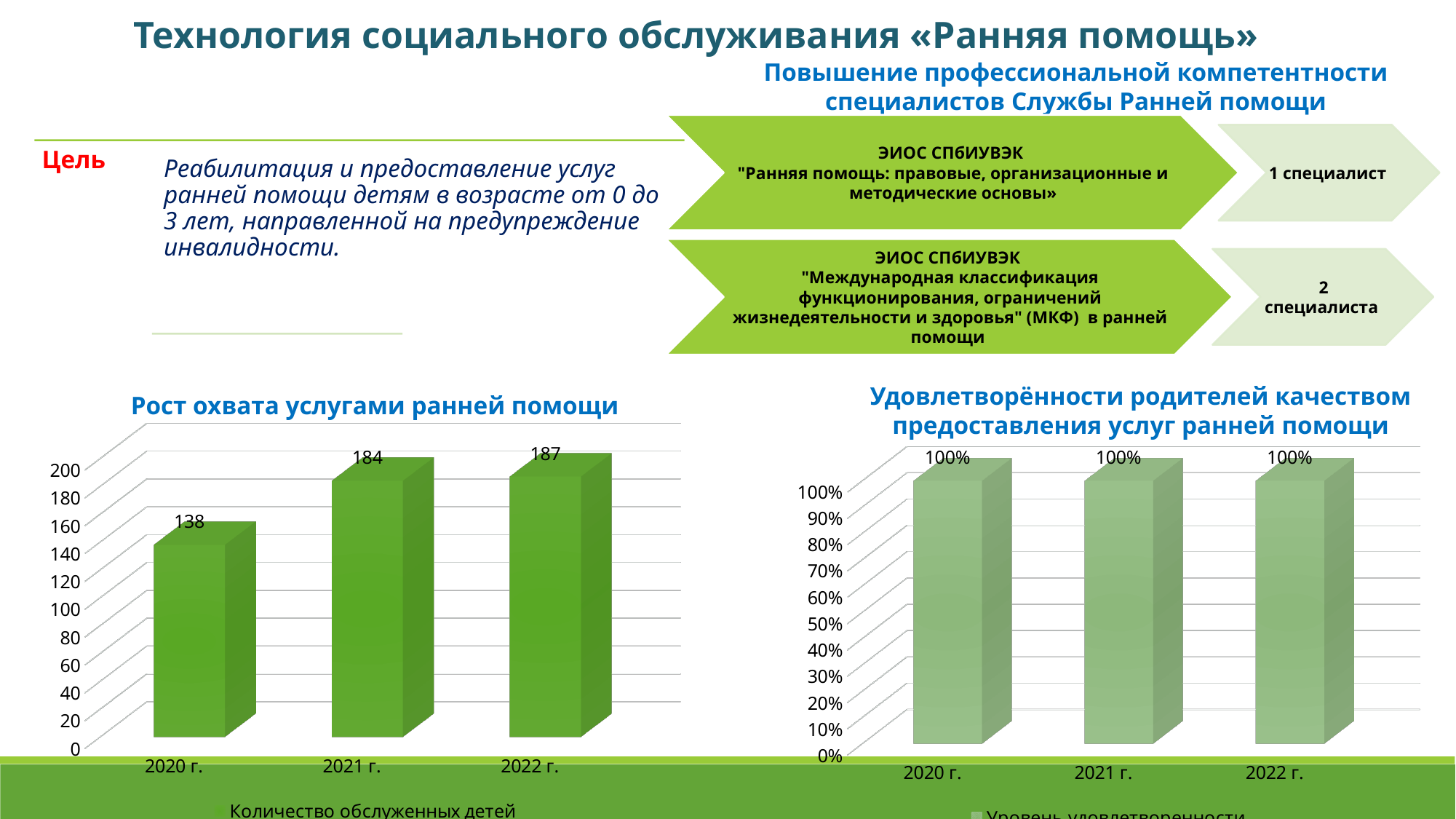
What kind of chart is 'Удовлетворённости родителей качеством предоставления услуг ранней помощи'? bar chart In the chart 'Рост охвата услугами ранней помощи', which year has the lowest value? 2020 г. In the chart 'Рост охвата услугами ранней помощи', what is the difference between the values for 2021 г. and 2020 г.? 46 In the chart 'Рост охвата услугами ранней помощи', what is the legend entry for the series? Количество обслуженных детей In the chart 'Удовлетворённости родителей качеством предоставления услуг ранней помощи', what is the value for 2021 г.? 100% In the chart 'Рост охвата услугами ранней помощи', do the values rise or fall from 2020 г. to 2022 г.? rise In the chart 'Рост охвата услугами ранней помощи', what is the value for 2022 г.? 187 In the chart 'Рост охвата услугами ранней помощи', how many years are shown on the x axis? 3 In the chart 'Рост охвата услугами ранней помощи', what is the value for 2021 г.? 184 In the chart 'Рост охвата услугами ранней помощи', what is the value for 2020 г.? 138 In the chart 'Удовлетворённости родителей качеством предоставления услуг ранней помощи', how many bars are plotted? 3 In the chart 'Рост охвата услугами ранней помощи', what is the difference between the values for 2022 г. and 2020 г.? 49